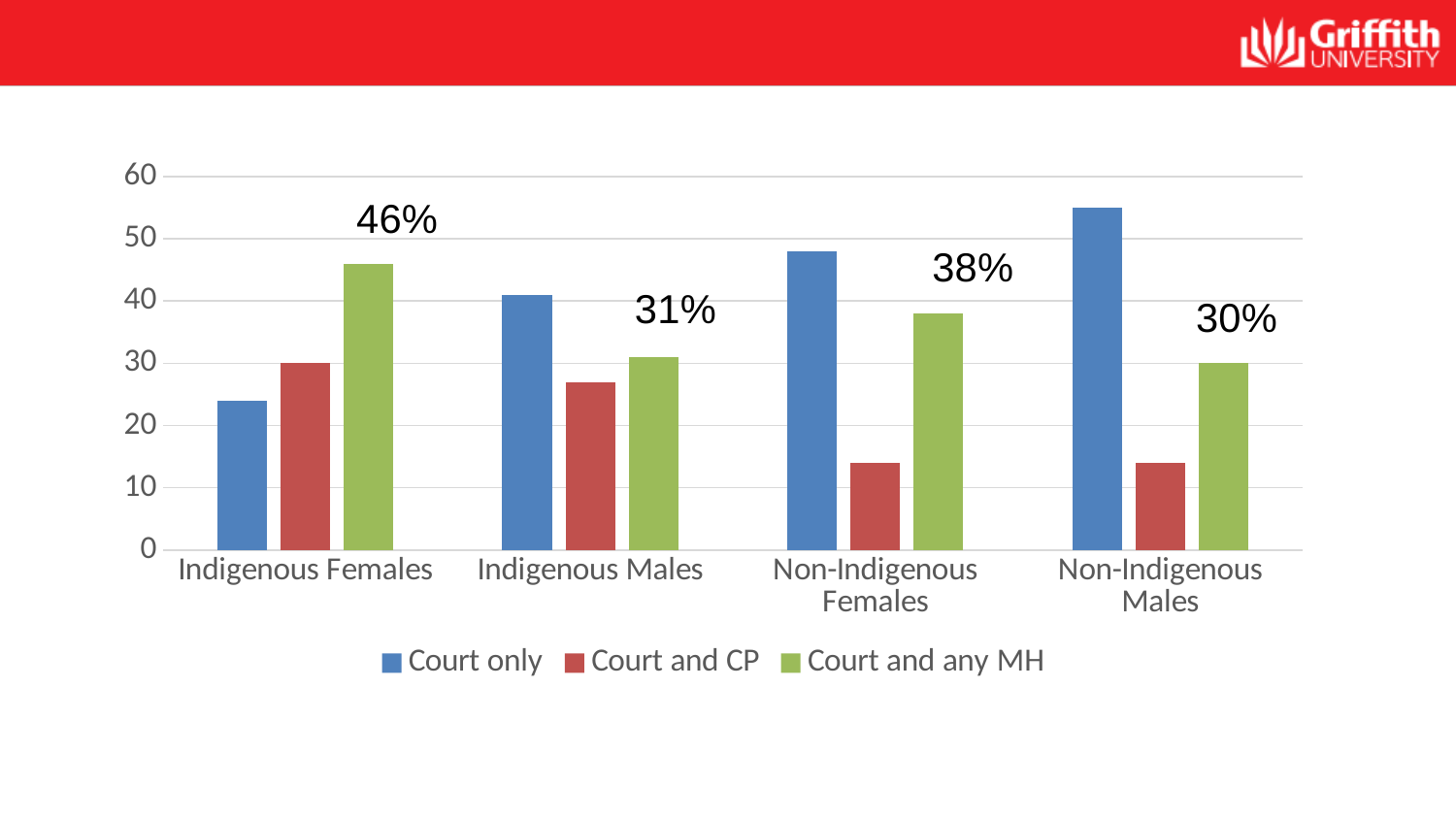
What is the value for Court and any MH for Non-Indigenous Females? 38% Is the Court and CP value for Non-Indigenous Females greater or less than 20? less Which category has the highest Court and any MH value? Indigenous Females Which category has the lowest Court and any MH value? Non-Indigenous Males Is the Court only value for Non-Indigenous Males greater or less than 50? greater What is the value for Court and any MH for Indigenous Females? 46% What kind of chart is shown on the slide? Bar chart How many series does the legend list? 3 How many categories are shown on the x axis? 4 What is the difference between the Court and any MH values for Indigenous Females and Non-Indigenous Females? 8% What is the value for Court and any MH for Non-Indigenous Males? 30% Which is larger: the Court and any MH value for Indigenous Males or for Non-Indigenous Females? Non-Indigenous Females